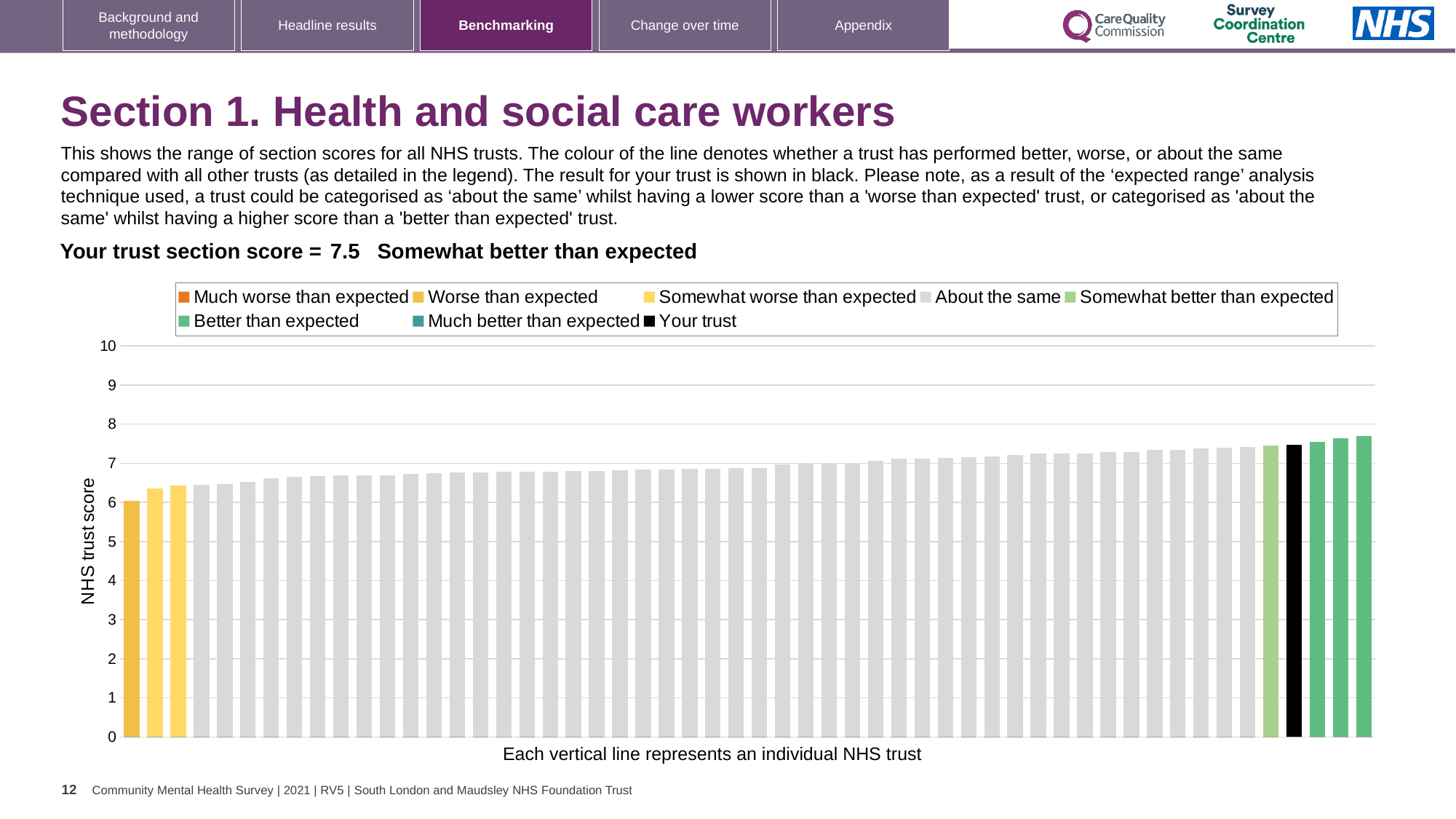
What colour is the bar representing your trust? Black Do the bar values rise or fall moving from left to right along the x axis? Rise Is the value of the black bar (your trust) greater or less than 8? less How many bars are coloured yellow (worse than expected)? 3 Is the black bar for your trust the highest bar on the chart? No Is the value of the rightmost bar greater or less than 7? greater How many entries does the chart legend list? 8 Which is higher: the black bar for your trust or the leftmost bar? The black bar for your trust What is the label on the vertical axis of the chart? NHS trust score What is the section score for your trust shown on the slide? 7.5 Is the value of the leftmost bar greater or less than 7? less What kind of chart is shown on the slide? Bar chart